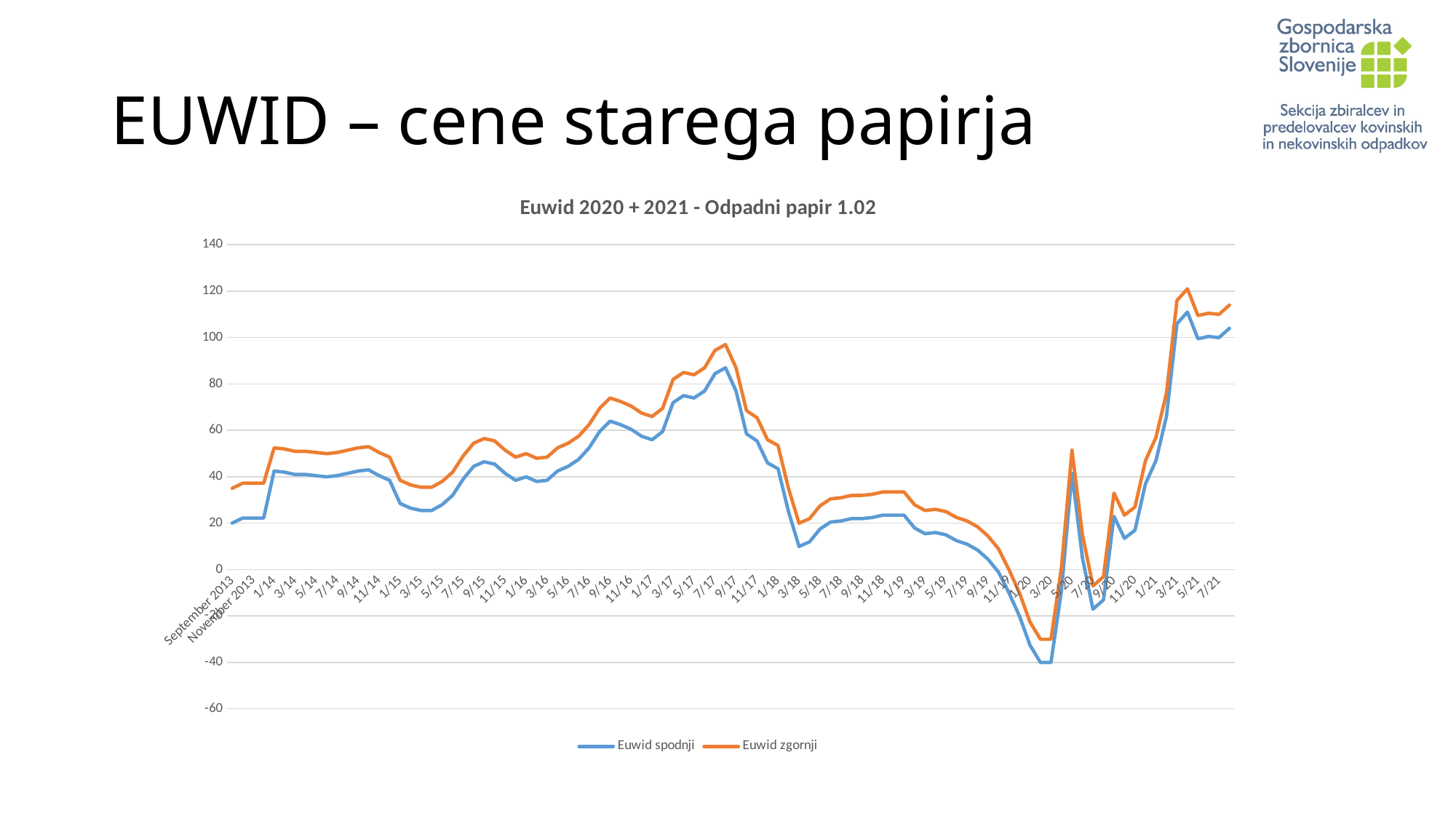
Between 9/17 and 3/18, does the Euwid spodnji line rise or fall? Fall Is the value for Euwid spodnji at September 2013 greater or less than 40? less Which series is drawn in orange? Euwid zgornji Is the value for Euwid spodnji at 3/20 greater or less than -20? less Which series reaches the highest value on the chart? Euwid zgornji What is the title of the chart? Euwid 2020 + 2021 - Odpadni papir 1.02 What kind of chart is shown on the slide? Line chart How many series does the legend list? 2 Is the value for Euwid zgornji at 9/17 greater or less than 80? greater At 9/17, which series has the higher value, Euwid spodnji or Euwid zgornji? Euwid zgornji